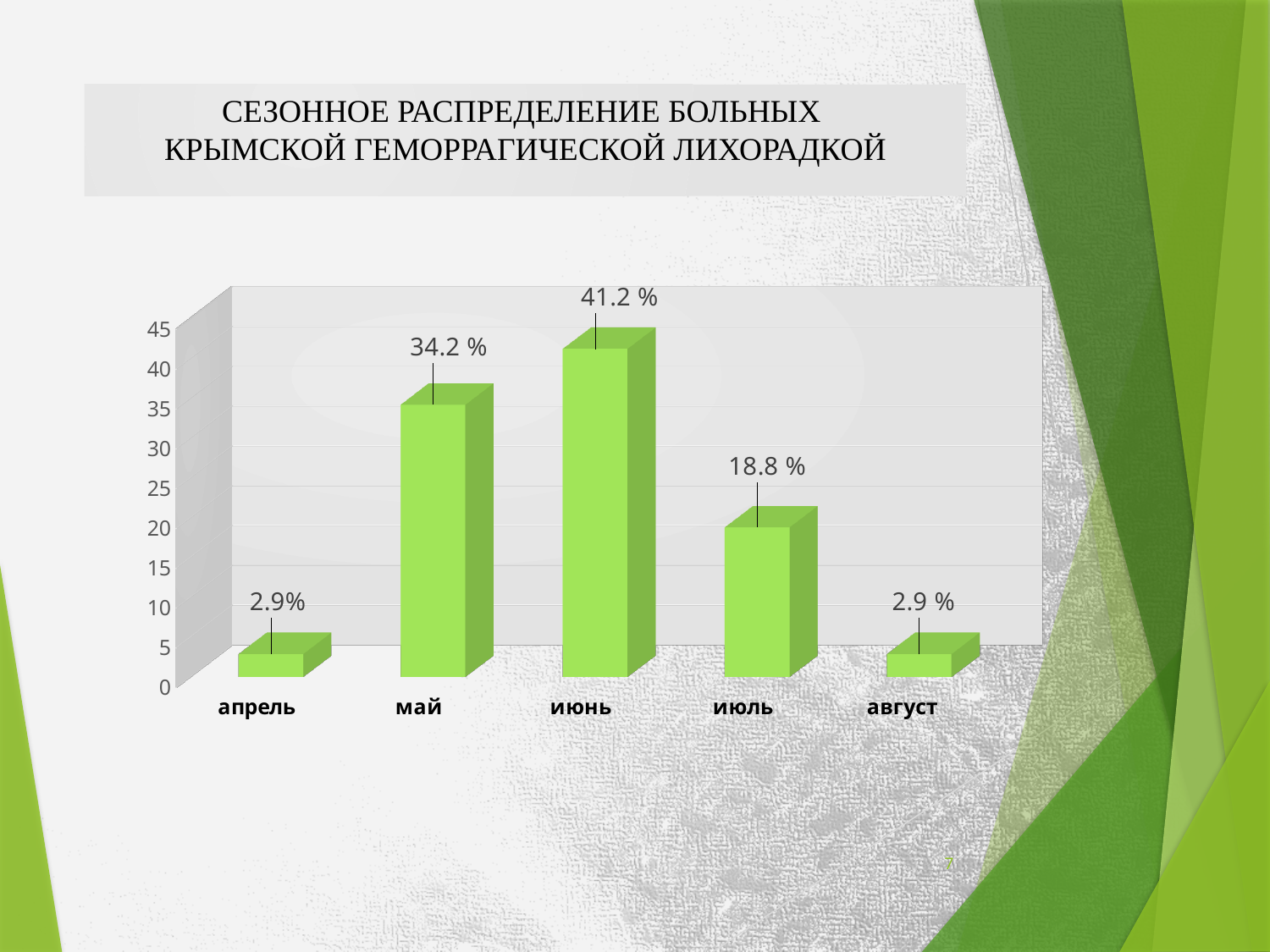
Is the value for июль greater or less than 20? less What is the value for июль? 18.8 % What is the value for апрель? 2.9% Which month has the highest value? июнь Which is larger, the value for май or the value for июль? май What is the difference between the values for июнь and май? 7.0 % What kind of chart is shown on the slide? bar chart Which months share the lowest value? апрель and август How many months are shown on the x axis? 5 How do the values change from апрель to август? They rise from апрель to июнь, then fall to август What is the value for май? 34.2 % What is the difference between the values for май and июль? 15.4 %